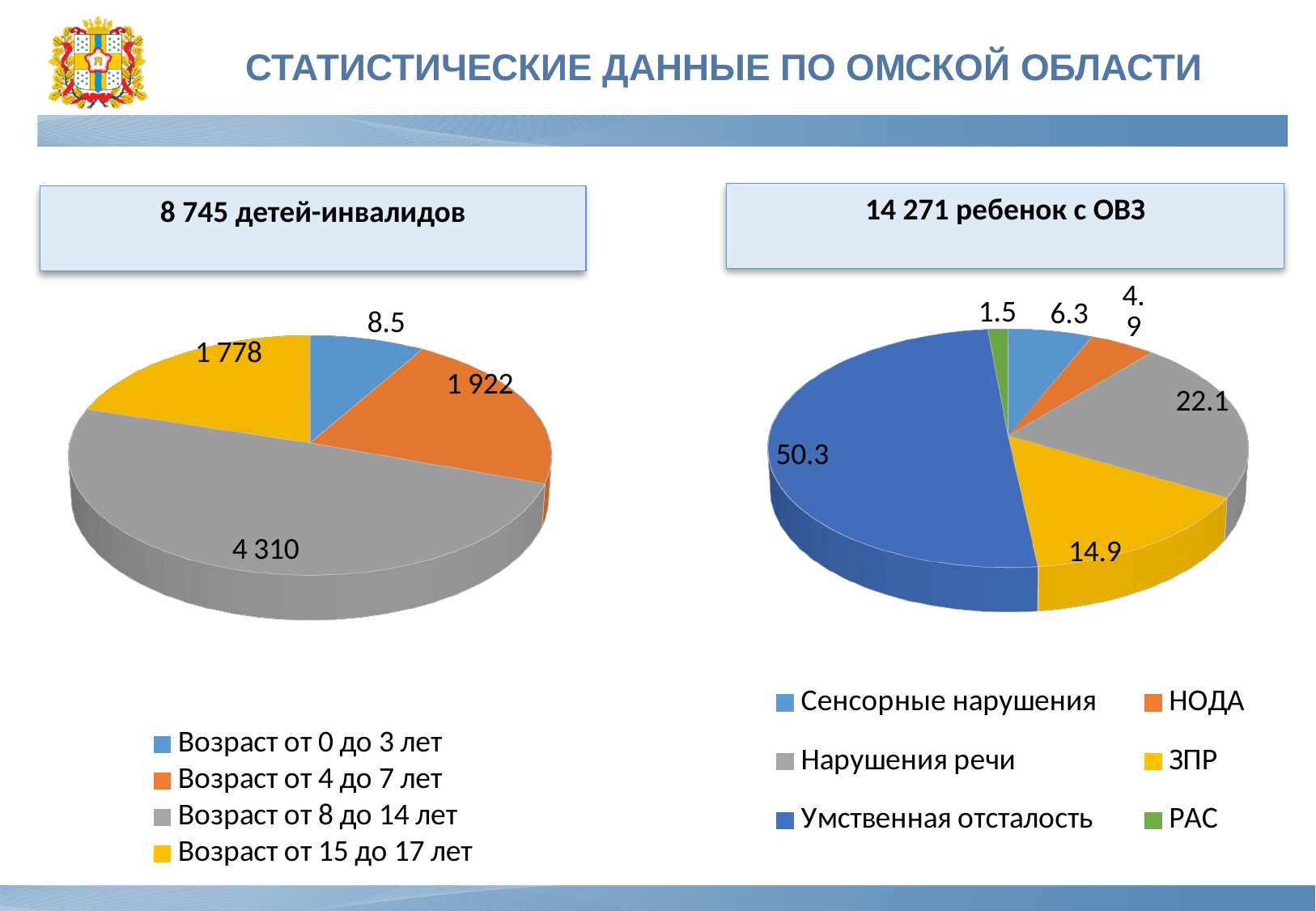
On the chart titled «14 271 ребенок с ОВЗ», what is the value for «РАС»? 1.5 On the chart titled «8 745 детей-инвалидов», what is the value for «Возраст от 15 до 17 лет»? 1 778 On the chart titled «14 271 ребенок с ОВЗ», what is the value for «Умственная отсталость»? 50.3 On the chart titled «8 745 детей-инвалидов», what is the value for «Возраст от 8 до 14 лет»? 4 310 On the chart titled «8 745 детей-инвалидов», how many categories does the legend list? 4 On the chart titled «14 271 ребенок с ОВЗ», which is larger: «ЗПР» or «НОДА»? ЗПР On the chart titled «8 745 детей-инвалидов», what is the value for «Возраст от 4 до 7 лет»? 1 922 On the chart titled «8 745 детей-инвалидов», what is the difference between the values for «Возраст от 4 до 7 лет» and «Возраст от 15 до 17 лет»? 144 On the chart titled «14 271 ребенок с ОВЗ», which category has the smallest slice? РАС What type of chart is used on the right side of the slide, titled «14 271 ребенок с ОВЗ»? Pie chart On the chart titled «8 745 детей-инвалидов», which age group has the largest slice? Возраст от 8 до 14 лет On the chart titled «14 271 ребенок с ОВЗ», what is the value for «Нарушения речи»? 22.1